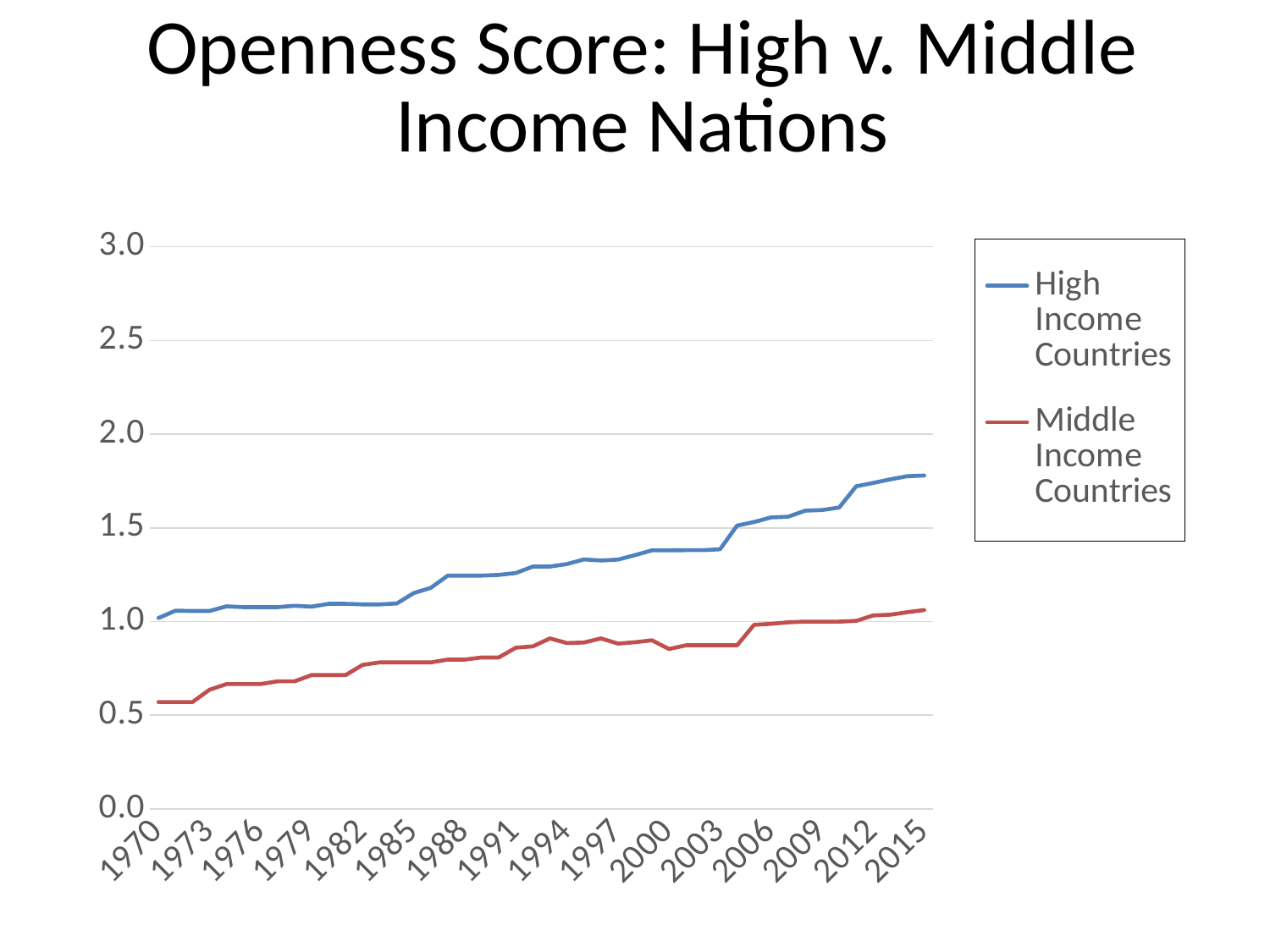
Is the value for Middle Income Countries in 1970 greater or less than 1.0? less Does the High Income Countries line rise or fall from 1970 to 2015? rise Is the value for Middle Income Countries in 2000 greater or less than 1.0? less How many series does the legend list? 2 How many year labels are shown on the x axis? 16 Which series is drawn in red? Middle Income Countries Is the value for High Income Countries in 2000 greater or less than 1.0? greater Which series has the higher value in 2015, High Income Countries or Middle Income Countries? High Income Countries What kind of chart is shown on the slide? line chart What is the title of the chart? Openness Score: High v. Middle Income Nations